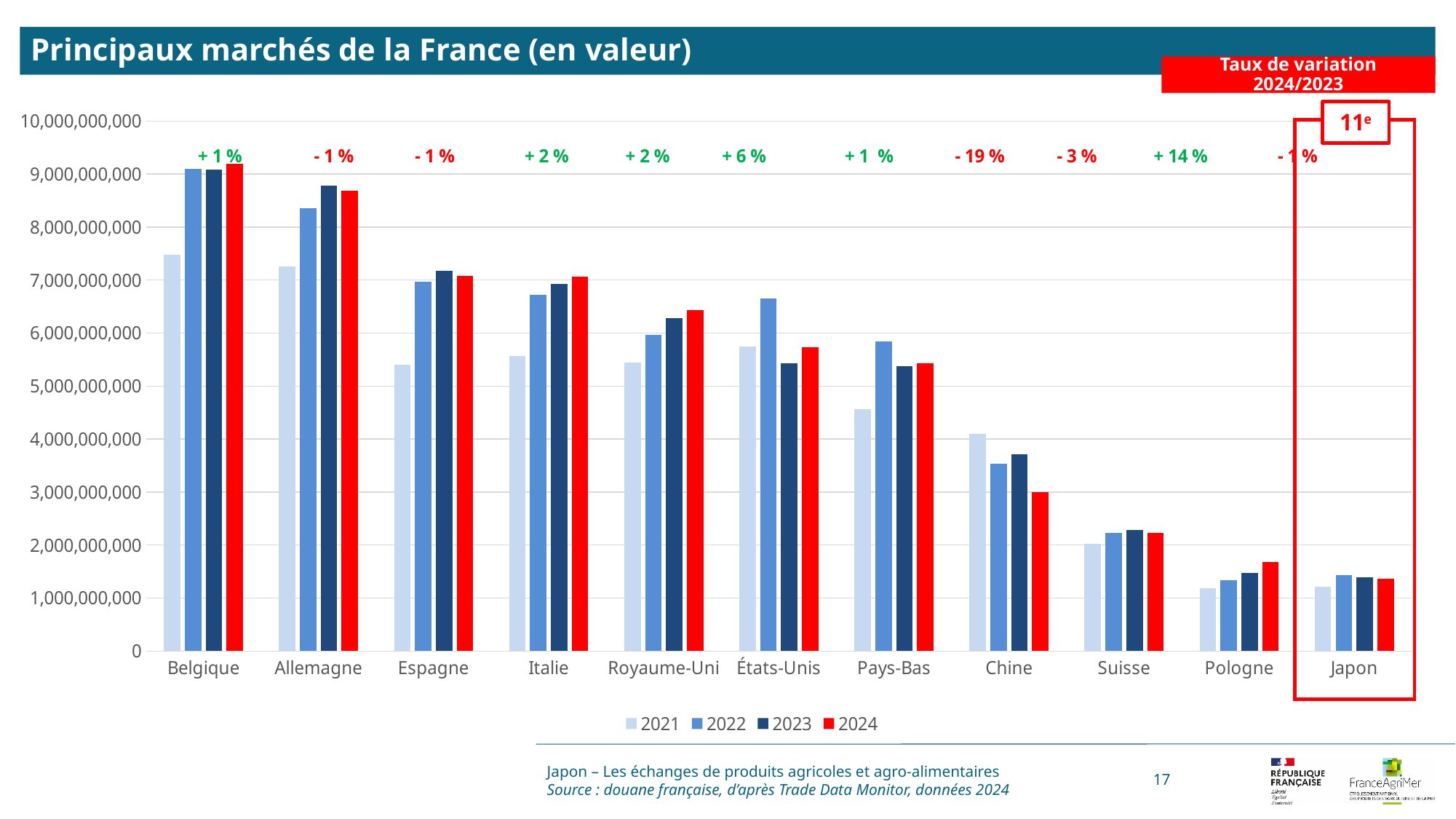
What is the 2024/2023 variation rate shown for Chine? - 19 % What rank is indicated for Japon in the red box? 11e What is the 2024/2023 variation rate shown for Pologne? + 14 % Is the 2024 value for Pologne greater or less than 2,000,000,000? less Which is larger, the 2024 value for Allemagne or the 2024 value for Espagne? Allemagne How many countries are shown on the x axis? 11 What is the 2024/2023 variation rate shown for États-Unis? + 6 % Is the 2024 value for Belgique greater or less than 9,000,000,000? greater Which country has the lowest value for 2024? Japon Which country has the highest value for 2024? Belgique How many series does the legend list? 4 What kind of chart is shown on the slide? bar chart